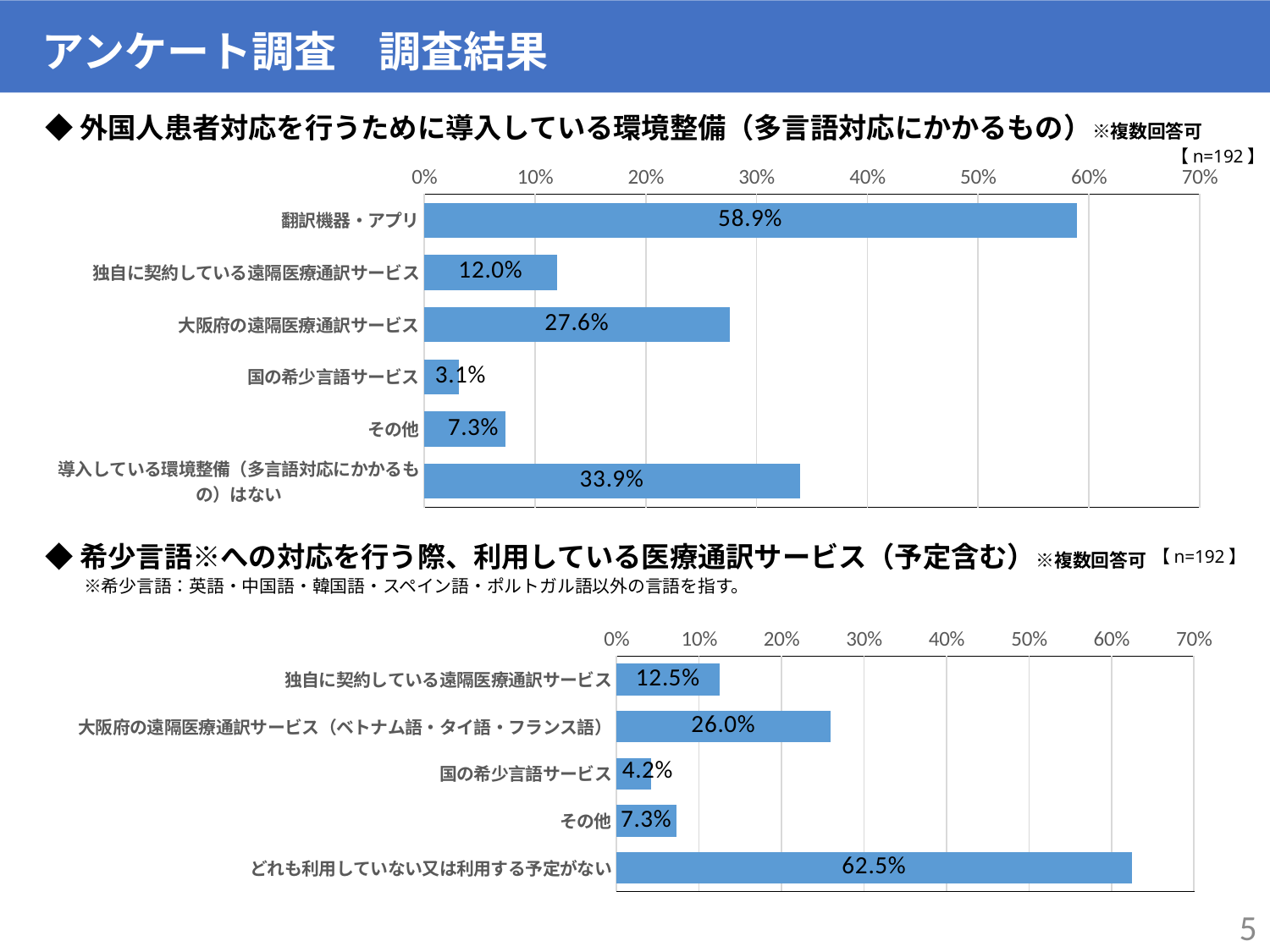
In the bottom chart, what is the difference between 大阪府の遠隔医療通訳サービス（ベトナム語・タイ語・フランス語） and 国の希少言語サービス? 21.8% In the top chart, how many categories are shown? 6 In the top chart, what is the difference between 翻訳機器・アプリ and 導入している環境整備（多言語対応にかかるもの）はない? 25.0% In the bottom chart, which category has the highest value? どれも利用していない又は利用する予定がない In the top chart, is the value for 独自に契約している遠隔医療通訳サービス greater or less than 10%? greater What kind of chart is the bottom chart? Bar chart In the top chart, which category has the lowest value? 国の希少言語サービス In the bottom chart, which is larger: 独自に契約している遠隔医療通訳サービス or 大阪府の遠隔医療通訳サービス（ベトナム語・タイ語・フランス語）? 大阪府の遠隔医療通訳サービス（ベトナム語・タイ語・フランス語） In the top chart, what is the value for 大阪府の遠隔医療通訳サービス? 27.6% In the bottom chart, how many categories are shown? 5 In the bottom chart, what is the value for どれも利用していない又は利用する予定がない? 62.5% In the top chart, what is the value for 翻訳機器・アプリ? 58.9%